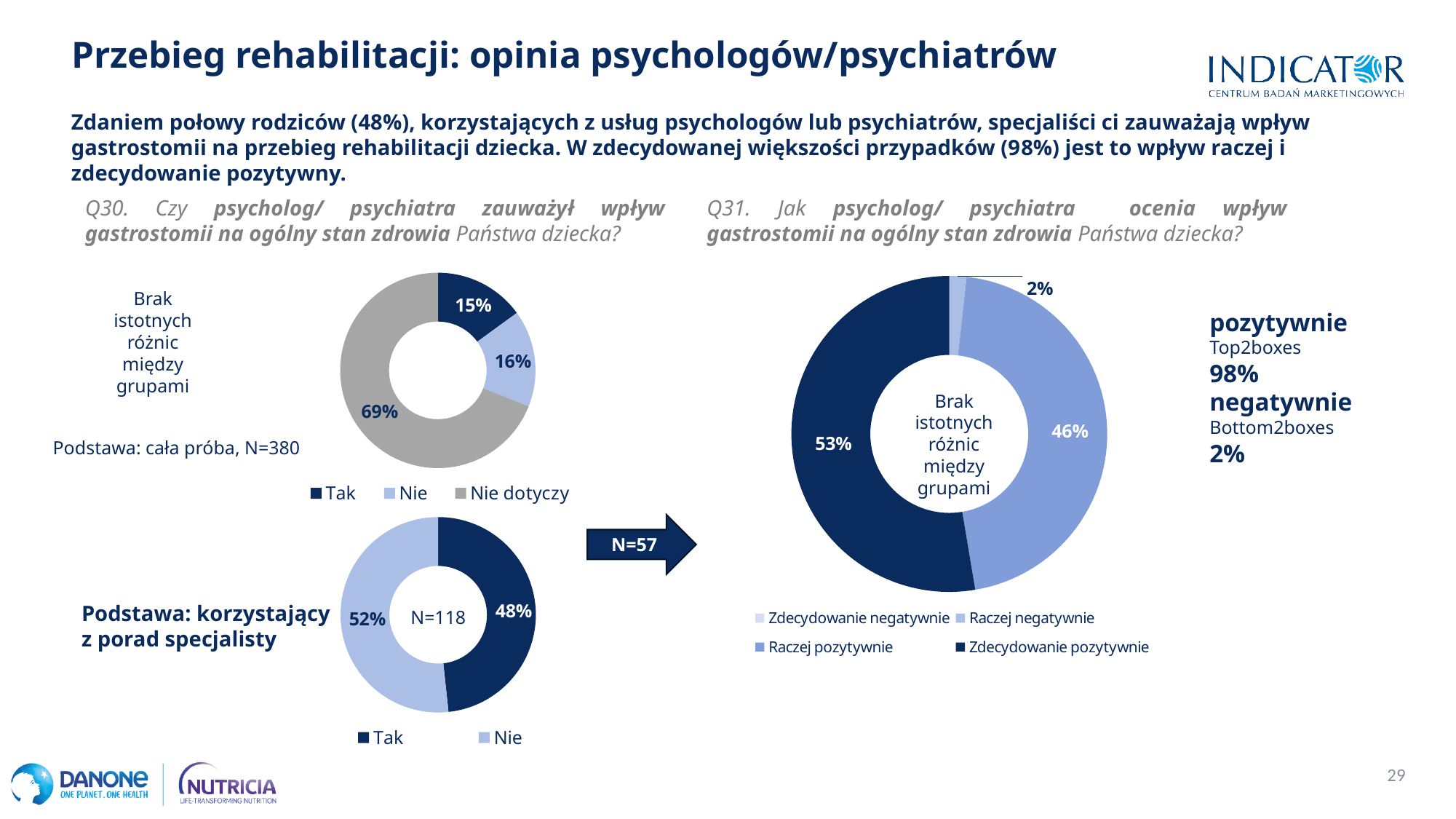
In the top-left Q30 donut chart (cała próba, N=380), which category has the largest share? Nie dotyczy In the bottom-left Q30 donut chart (korzystający z porad specjalisty, N=118), what is the difference between 'Nie' and 'Tak'? 4 percentage points In the right-hand Q31 donut chart, how many entries does the legend list? 4 In the right-hand Q31 donut chart, what percentage is shown for 'Zdecydowanie pozytywnie'? 53% In the top-left Q30 donut chart (cała próba, N=380), what percentage is shown for 'Nie dotyczy'? 69% In the top-left Q30 donut chart (cała próba, N=380), what percentage is shown for 'Tak'? 15% In the bottom-left Q30 donut chart (korzystający z porad specjalisty, N=118), which is larger, 'Tak' or 'Nie'? Nie In the right-hand Q31 donut chart, what percentage is shown for 'Raczej pozytywnie'? 46% In the top-left Q30 donut chart (cała próba, N=380), which category has the smallest share? Tak In the top-left Q30 donut chart (cała próba, N=380), how many entries does the legend list? 3 What type of chart is used for Q31 on the right side of the slide? Donut (pie) chart In the bottom-left Q30 donut chart (korzystający z porad specjalisty, N=118), what percentage is shown for 'Tak'? 48%